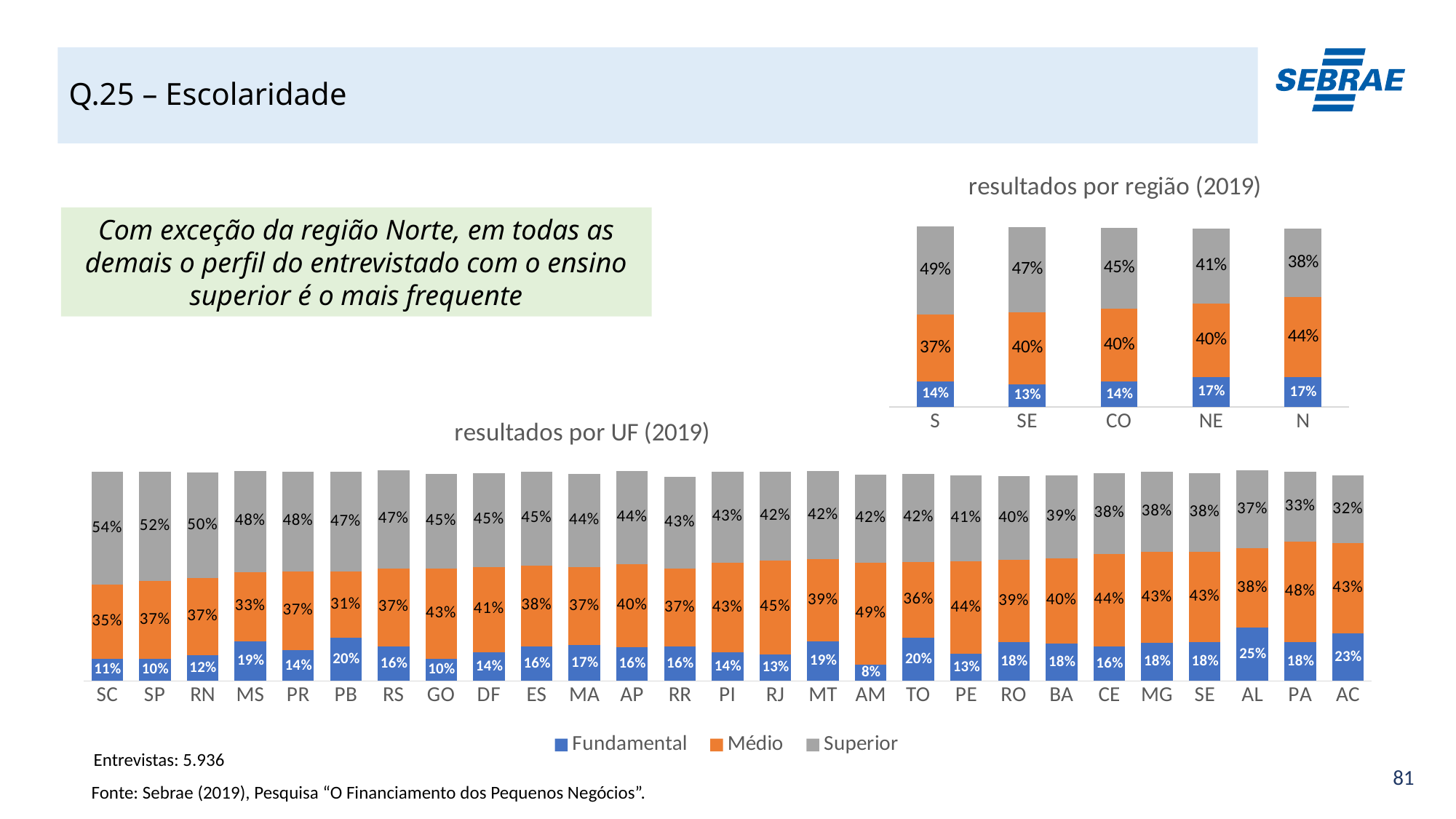
How many UFs are shown in the 'resultados por UF (2019)' chart? 27 In the 'resultados por UF (2019)' chart, which UF has the highest Fundamental value? AL In the 'resultados por UF (2019)' chart, which is larger, the Superior value for SP or for AC? SP In the 'resultados por região (2019)' chart, what is the Médio value for region N? 44% In the 'resultados por região (2019)' chart, what is the Superior value for region S? 49% In the 'resultados por UF (2019)' chart, which UF has the highest Superior value? SC What type of chart is the 'resultados por região (2019)' chart? Stacked bar chart In the 'resultados por UF (2019)' chart, what is the Fundamental value for AM? 8% How many series does the legend of the 'resultados por UF (2019)' chart list? 3 In the 'resultados por região (2019)' chart, what is the difference between the Superior values for S and N? 11% In the 'resultados por UF (2019)' chart, what is the Médio value for PA? 48% In the 'resultados por região (2019)' chart, which region has the lowest Superior value? N